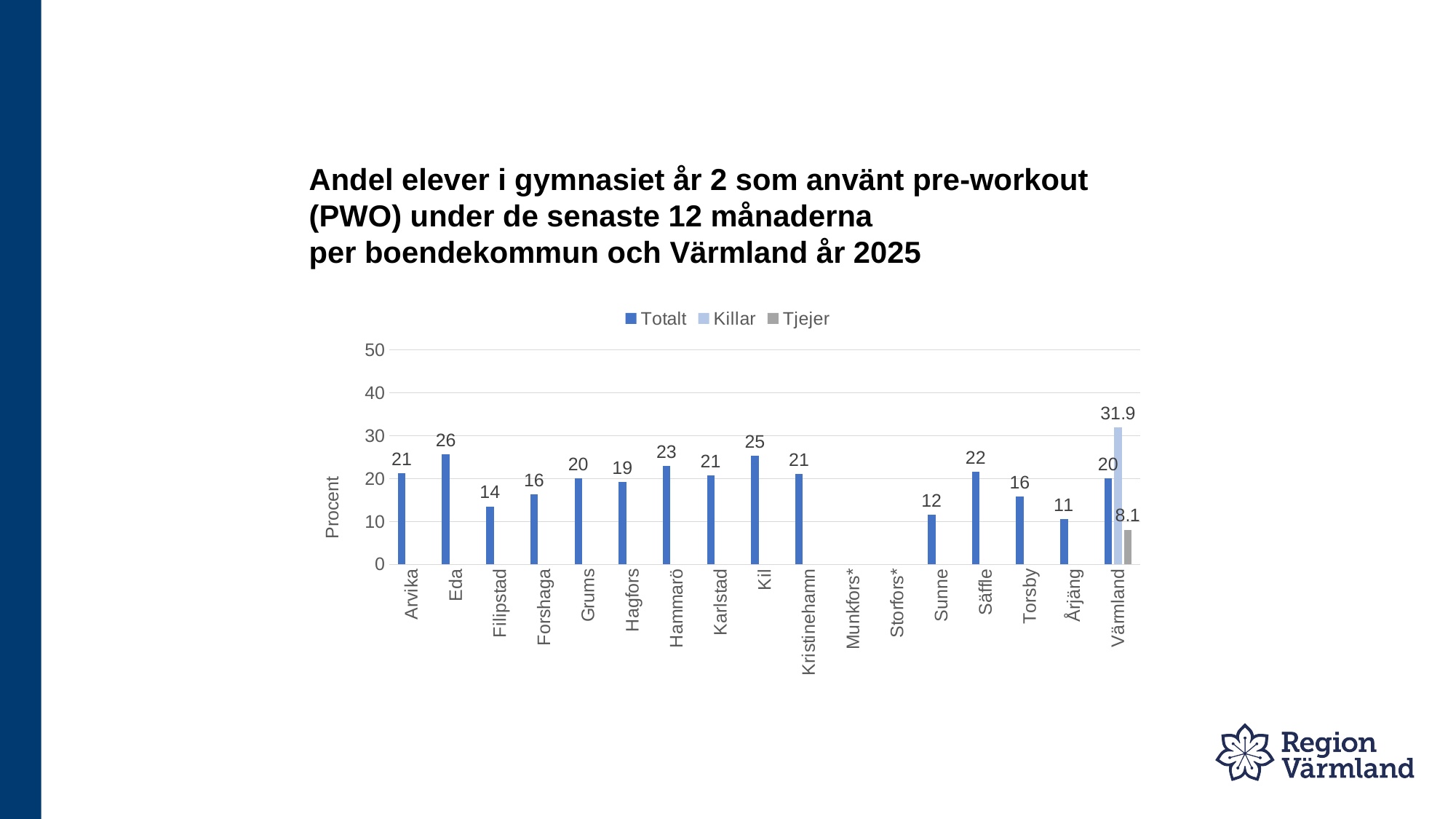
What is the Totalt value for Eda? 26 Which two categories on the x axis have no bars plotted? Munkfors* and Storfors* What is the difference between the Killar and Tjejer values for Värmland? 23.8 What kind of chart is shown on the slide? bar chart What is the Tjejer value for Värmland? 8.1 How many series does the legend list? 3 Which municipality has the highest Totalt value? Eda Is the Totalt value for Sunne greater or less than 20? less What is the label of the y axis? Procent What is the Killar value for Värmland? 31.9 Which municipality with a plotted bar has the lowest Totalt value? Årjäng Which is larger, the Totalt value for Kil or for Säffle? Kil